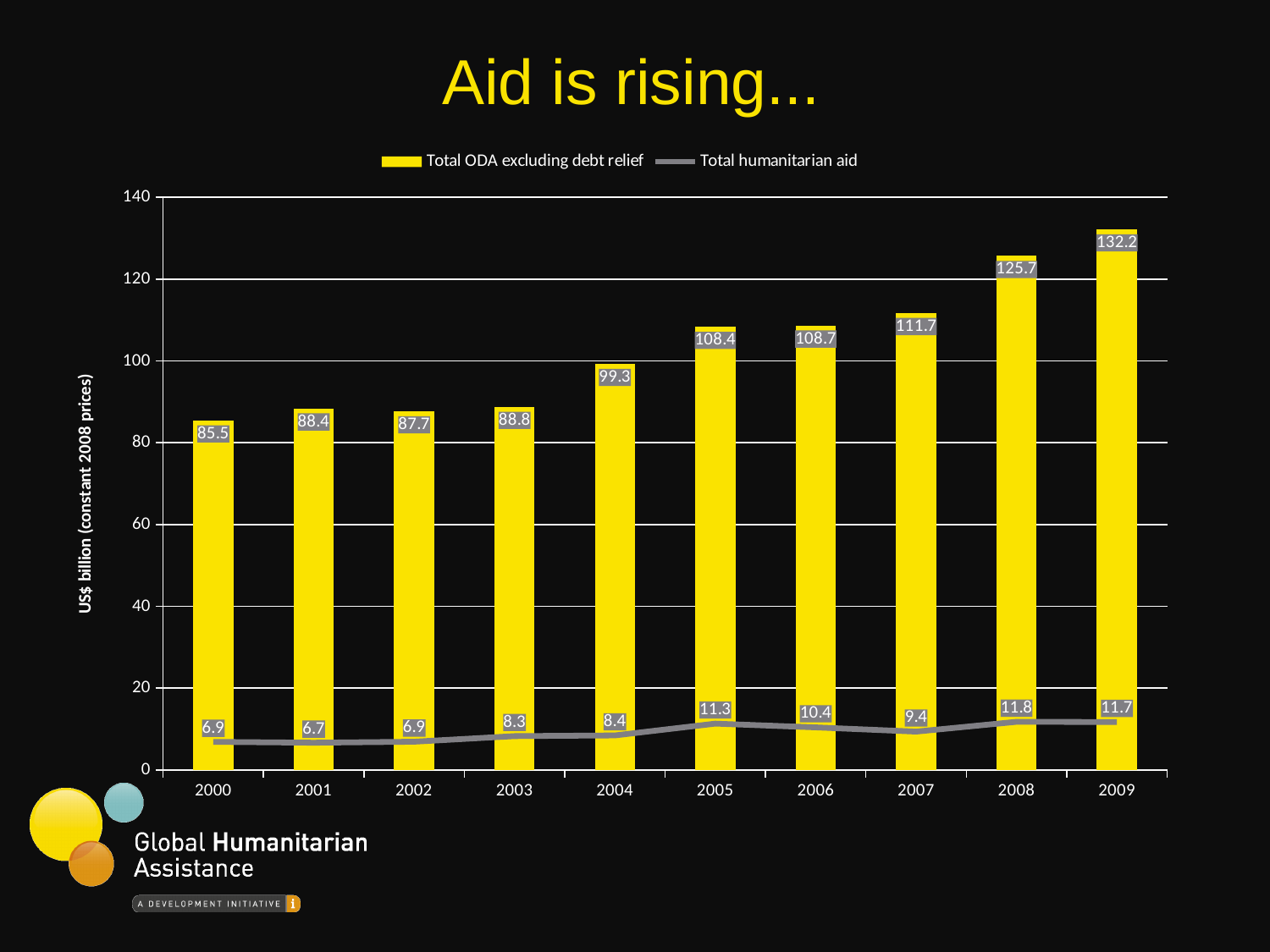
What is the value of Total ODA excluding debt relief in 2000? 85.5 What is the title of the slide? Aid is rising... What is the value of Total humanitarian aid in 2005? 11.3 What is the difference between Total ODA excluding debt relief in 2009 and in 2008? 6.5 Which is larger, Total humanitarian aid in 2006 or in 2007? 2006 Which year has the lowest Total humanitarian aid? 2001 Is the value of Total ODA excluding debt relief in 2004 greater or less than 100? less Which year has the highest Total ODA excluding debt relief? 2009 How many series does the legend list? 2 What is the value of Total ODA excluding debt relief in 2009? 132.2 What kind of chart is used for Total ODA excluding debt relief? bar chart How many years are shown on the x axis? 10